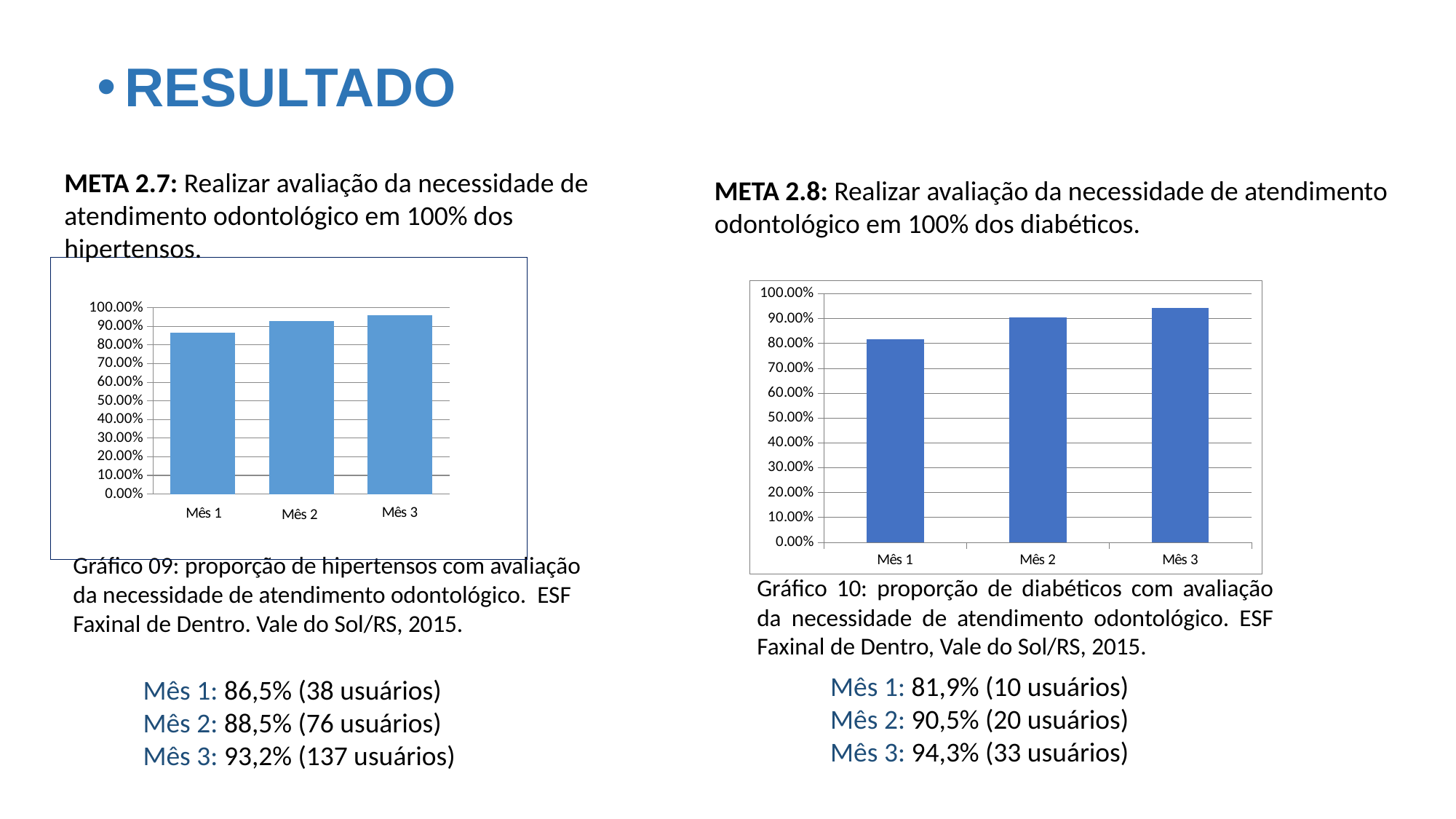
In Gráfico 10 (the right chart), is the value for Mês 2 greater or less than 80.00%? greater What kind of chart is Gráfico 09 (the left chart)? bar chart How many months are plotted in Gráfico 09 (the left chart)? 3 In Gráfico 10 (the right chart), which month has the lowest bar? Mês 1 In Gráfico 09 (the left chart), is the value for Mês 1 greater or less than 80.00%? greater In Gráfico 10 (the right chart), which month has the highest bar? Mês 3 In Gráfico 09 (the left chart), which month has the highest bar? Mês 3 In Gráfico 09 (the left chart), do the values rise or fall from Mês 1 to Mês 3? rise In Gráfico 10 (the right chart), is the value for Mês 1 greater or less than 90.00%? less In Gráfico 10 (the right chart), which is larger, the value for Mês 2 or Mês 3? Mês 3 What is the highest tick shown on the y axis of Gráfico 10 (the right chart)? 100.00% In Gráfico 09 (the left chart), which month has the lowest bar? Mês 1